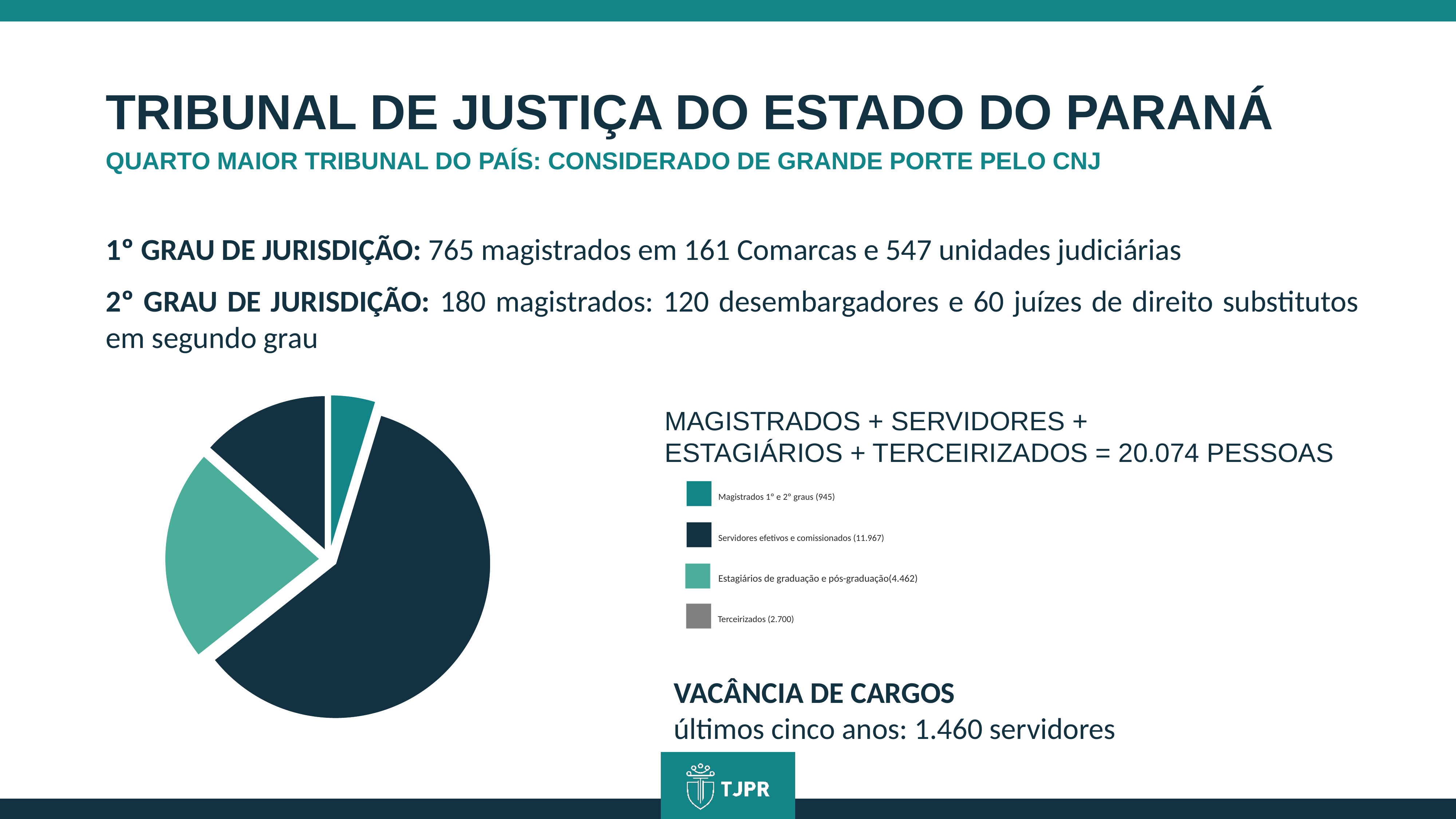
What is the value for Terceirizados in the pie chart? 2.700 What is the difference between Servidores efetivos e comissionados and Estagiários de graduação e pós-graduação? 7.505 How many categories does the pie chart have? 4 What colour does the legend use for Terceirizados? grey What is the total number of people represented by the pie chart? 20.074 What is the value for Estagiários de graduação e pós-graduação in the pie chart? 4.462 Which is larger: Estagiários de graduação e pós-graduação or Terceirizados? Estagiários de graduação e pós-graduação Which category has the largest value in the pie chart? Servidores efetivos e comissionados Which category has the smallest value in the pie chart? Magistrados 1° e 2° graus What is the value for Servidores efetivos e comissionados in the pie chart? 11.967 What kind of chart is shown on the slide? pie chart What is the value for Magistrados 1° e 2° graus in the pie chart? 945